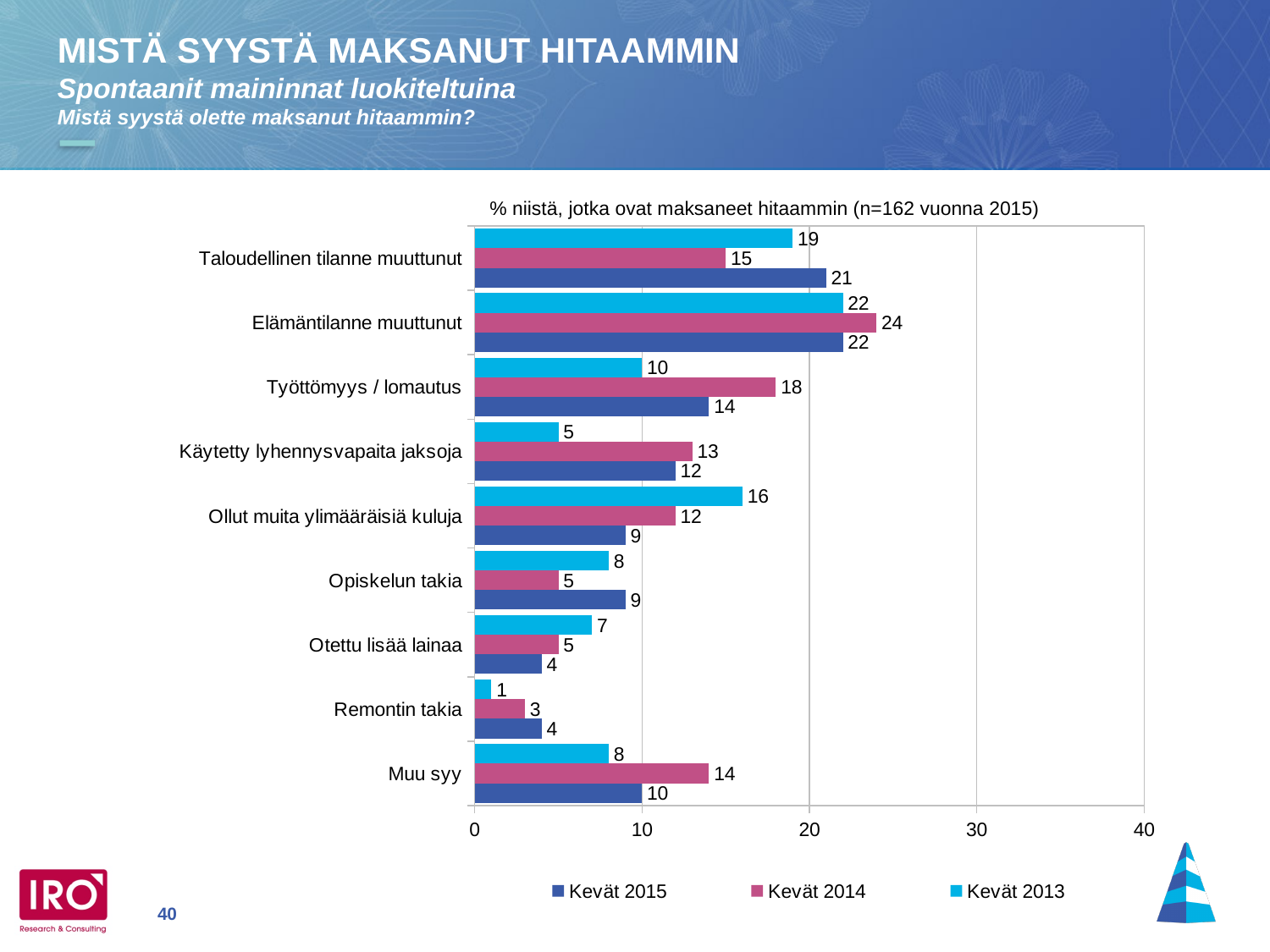
What is the difference between the Kevät 2015 and Kevät 2014 values for "Taloudellinen tilanne muuttunut"? 6 For "Ollut muita ylimääräisiä kuluja", which is larger: the Kevät 2013 value or the Kevät 2015 value? Kevät 2013 Which category has the highest value for Kevät 2014? Elämäntilanne muuttunut What is the value for Kevät 2013 for "Remontin takia"? 1 What kind of chart is shown on the slide? Bar chart What is the value for Kevät 2014 for "Työttömyys / lomautus"? 18 How many categories are shown on the chart? 9 How many series does the legend list? 3 Which category has the lowest value for Kevät 2013? Remontin takia Is the Kevät 2014 value for "Muu syy" greater or less than 10? greater What is the title shown above the chart? % niistä, jotka ovat maksaneet hitaammin (n=162 vuonna 2015) What is the value for Kevät 2015 for "Elämäntilanne muuttunut"? 22